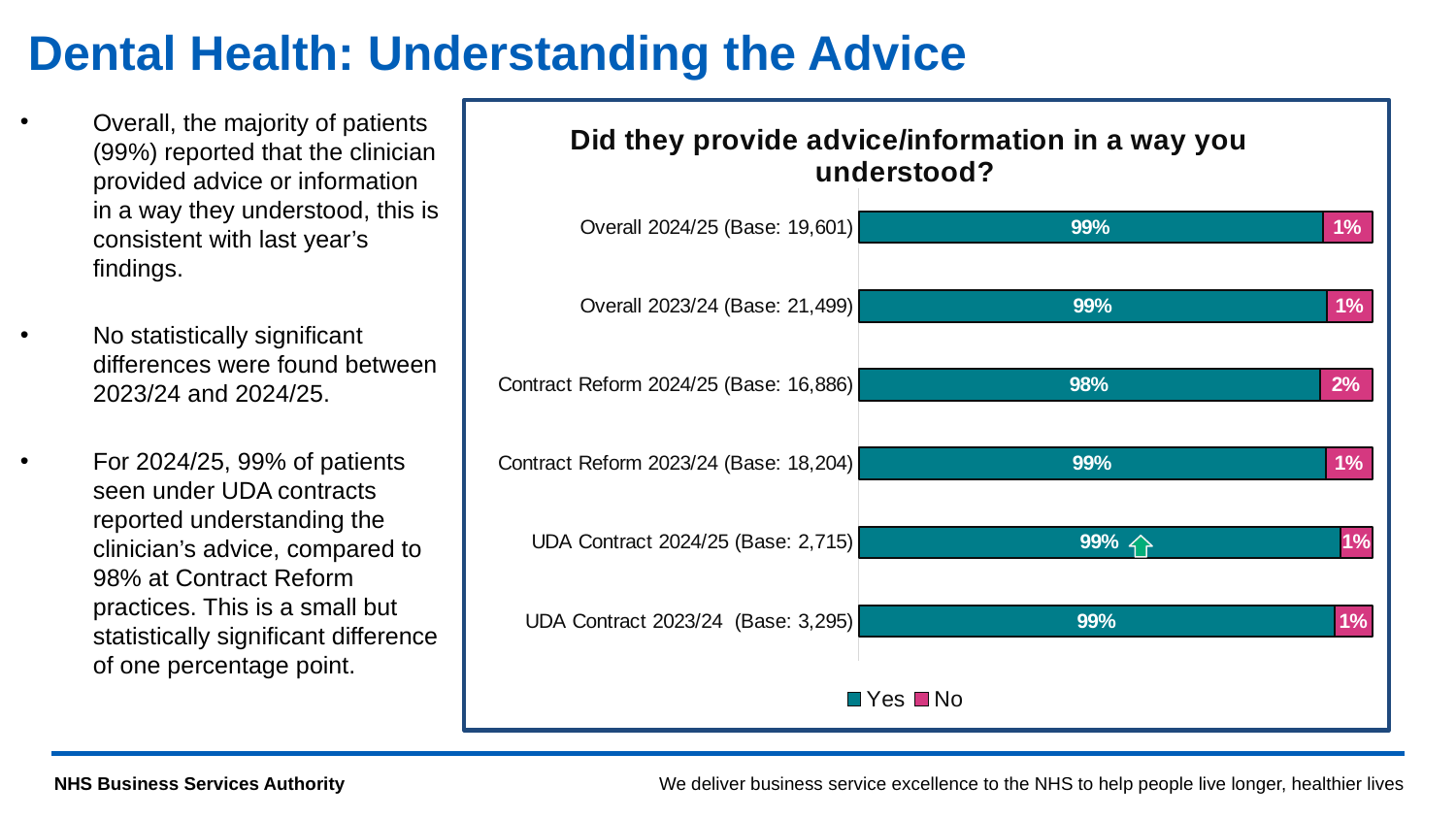
What is the Yes value for UDA Contract 2023/24? 99% How many categories are shown in the chart? 6 Which is larger, the Yes value for UDA Contract 2024/25 or the Yes value for Contract Reform 2024/25? UDA Contract 2024/25 What is the difference between the Yes percentage for Contract Reform 2023/24 and Contract Reform 2024/25? 1% What is the base size shown for Contract Reform 2024/25? 16,886 What percentage of Overall 2024/25 respondents answered Yes? 99% Which category has the lowest Yes percentage? Contract Reform 2024/25 How many series does the legend list? 2 What kind of chart is shown? Stacked bar chart Which category has the highest No percentage? Contract Reform 2024/25 What is the total of the Yes and No values for Overall 2023/24? 100% What percentage of Contract Reform 2024/25 respondents answered No? 2%